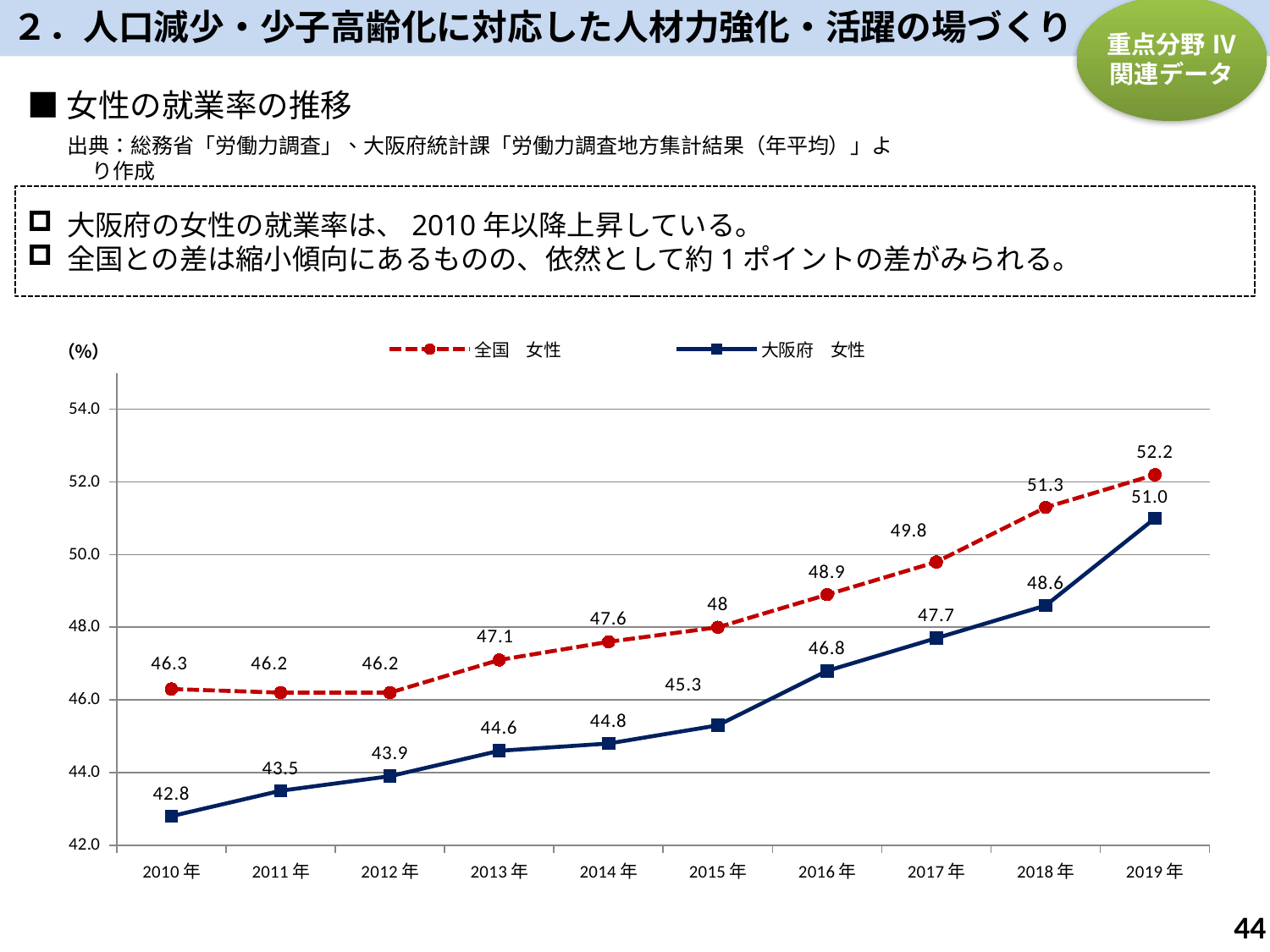
What is the difference between 全国 女性 and 大阪府 女性 in 2010年? 3.5 How many years are shown on the x axis? 10 What is the value for 全国 女性 in 2013年? 47.1 What is the difference between 全国 女性 and 大阪府 女性 in 2019年? 1.2 What is the value for 大阪府 女性 in 2010年? 42.8 What is the value for 全国 女性 in 2019年? 52.2 What is the value for 大阪府 女性 in 2015年? 45.3 Which is larger in 2016年, 全国 女性 or 大阪府 女性? 全国 女性 In which year is the value for 大阪府 女性 lowest? 2010年 What kind of chart is shown on the slide? line chart In which year is the value for 大阪府 女性 highest? 2019年 How many series does the legend list? 2